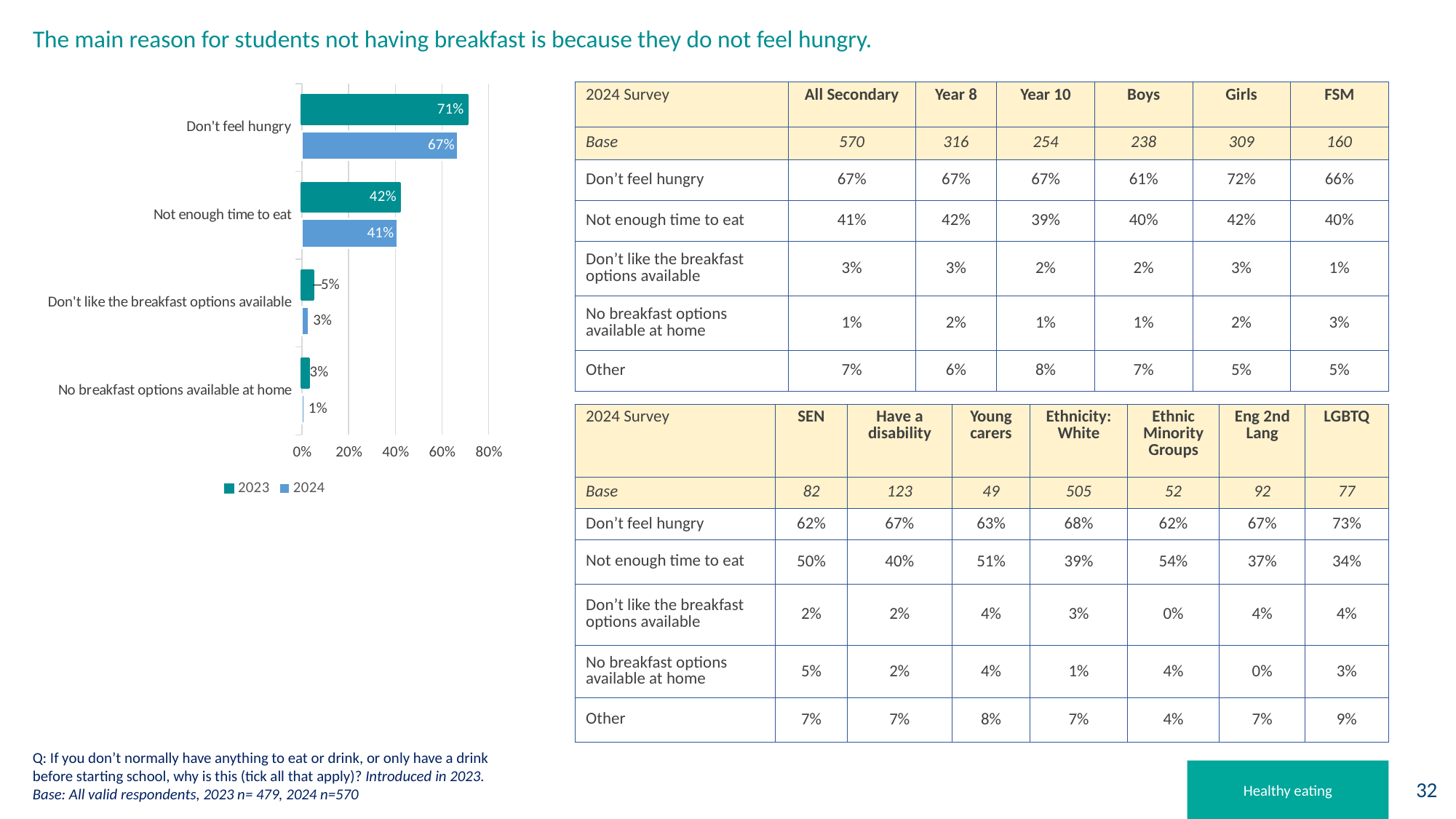
What is the 2024 value for 'Not enough time to eat' in the bar chart? 41% What kind of chart is shown on the slide? bar chart Which category has the lowest 2023 value in the bar chart? No breakfast options available at home What is the 2024 value for 'No breakfast options available at home' in the bar chart? 1% Which series in the bar chart is shown in light blue? 2024 Which category has the highest 2024 value in the bar chart? Don't feel hungry What is the 2023 value for 'Don't feel hungry' in the bar chart? 71% What is the difference between the 2023 and 2024 values for 'Don't feel hungry' in the bar chart? 4% In the bar chart, is the 2023 value for 'Don't like the breakfast options available' larger or smaller than the 2024 value? larger How many categories are shown in the bar chart? 4 Is the 2024 value for 'Don't feel hungry' in the bar chart greater or less than 60%? greater How many series does the legend of the bar chart list? 2